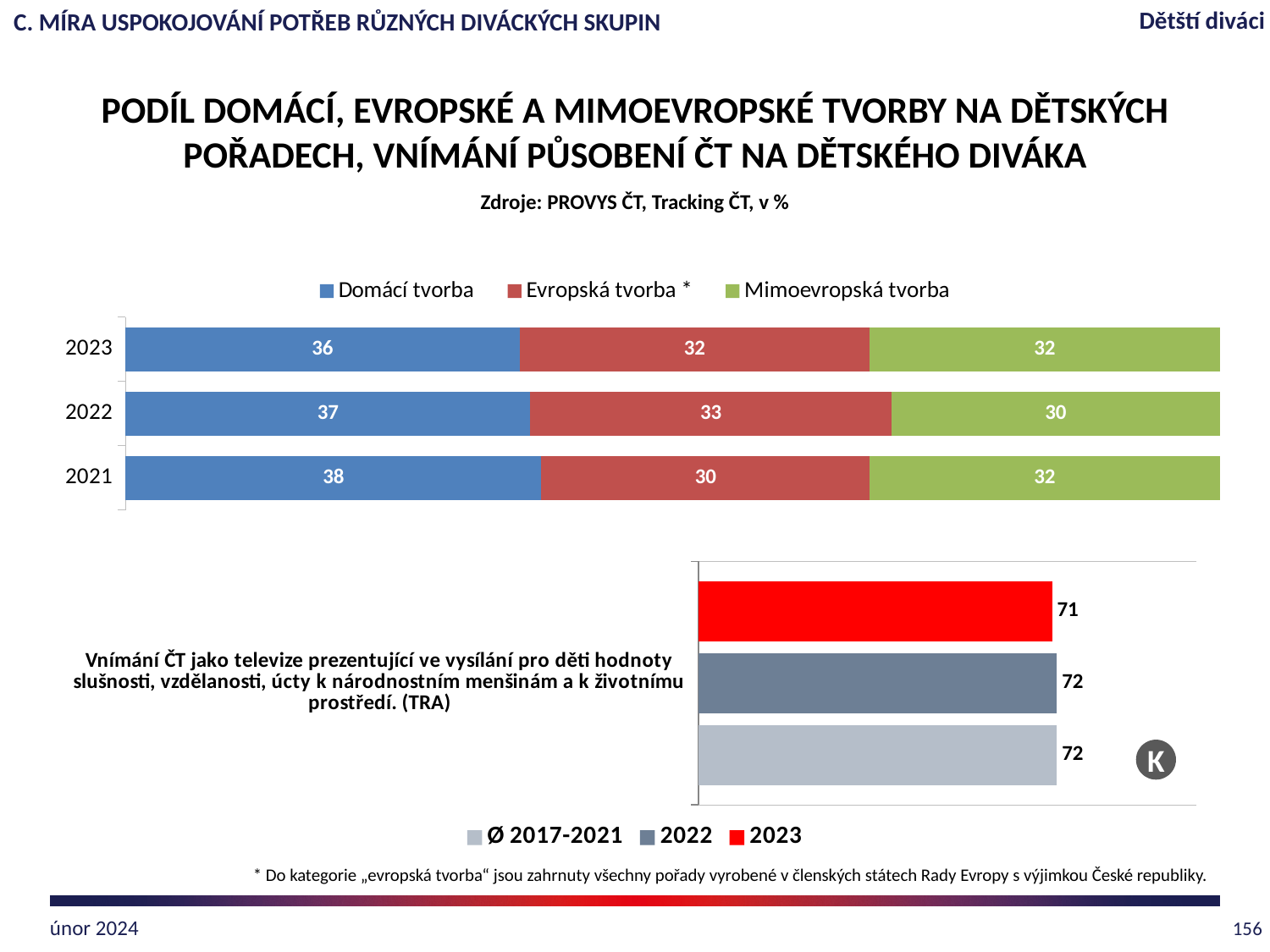
In the top stacked bar chart, what is the difference between Domácí tvorba and Evropská tvorba in 2021? 8 In the top stacked bar chart, what is the value for Mimoevropská tvorba in 2021? 32 In the bottom bar chart, what is the value for 2023? 71 What kind of chart is the bottom chart on the slide? bar chart In the top stacked bar chart, does the value for Domácí tvorba rise or fall from 2021 to 2023? fall In the top stacked bar chart, how many series does the legend list? 3 In the top stacked bar chart, what is the value for Domácí tvorba in 2023? 36 In the bottom bar chart, which is larger, the value for 2022 or the value for 2023? 2022 In the top stacked bar chart, what is the value for Evropská tvorba in 2022? 33 In the top stacked bar chart, which year has the lowest value for Evropská tvorba? 2021 In the top stacked bar chart, which year has the highest value for Domácí tvorba? 2021 In the top stacked bar chart, what is the total of the stacked bar for 2022? 100